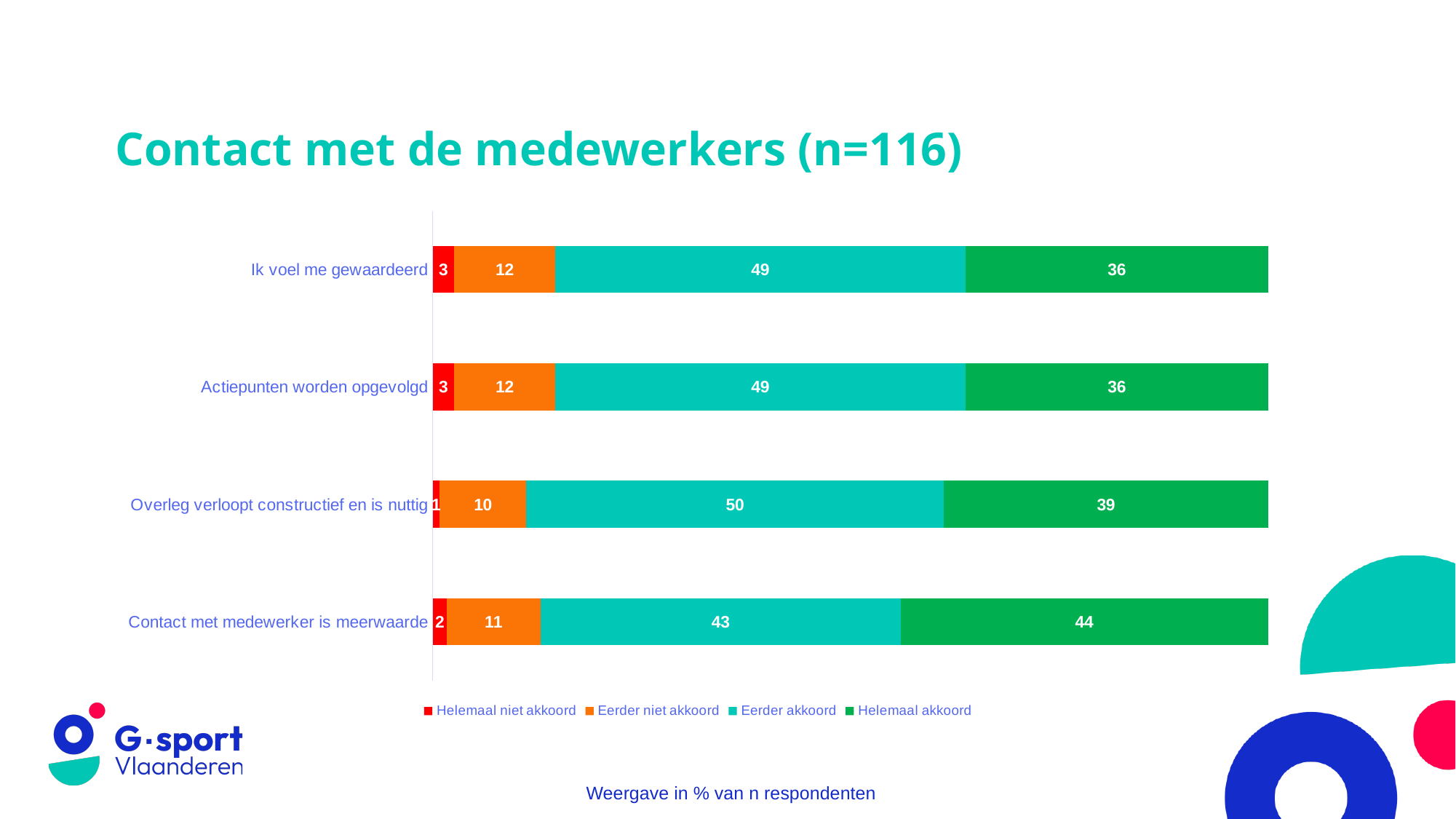
For "Contact met medewerker is meerwaarde", which is larger: "Eerder akkoord" or "Helemaal akkoord"? Helemaal akkoord What is the value for "Eerder niet akkoord" for "Overleg verloopt constructief en is nuttig"? 10 What is the value for "Helemaal akkoord" for "Contact met medewerker is meerwaarde"? 44 What is the value for "Eerder akkoord" for "Ik voel me gewaardeerd"? 49 How many series does the legend list? 4 Which category has the highest value for "Helemaal akkoord"? Contact met medewerker is meerwaarde What is the difference between the "Helemaal akkoord" values for "Overleg verloopt constructief en is nuttig" and "Ik voel me gewaardeerd"? 3 What kind of chart is shown on the slide? Stacked bar chart Which category has the lowest value for "Helemaal niet akkoord"? Overleg verloopt constructief en is nuttig How many categories are shown in the chart? 4 What is the total of the stacked bar for "Overleg verloopt constructief en is nuttig"? 100 What is the value for "Helemaal niet akkoord" for "Actiepunten worden opgevolgd"? 3